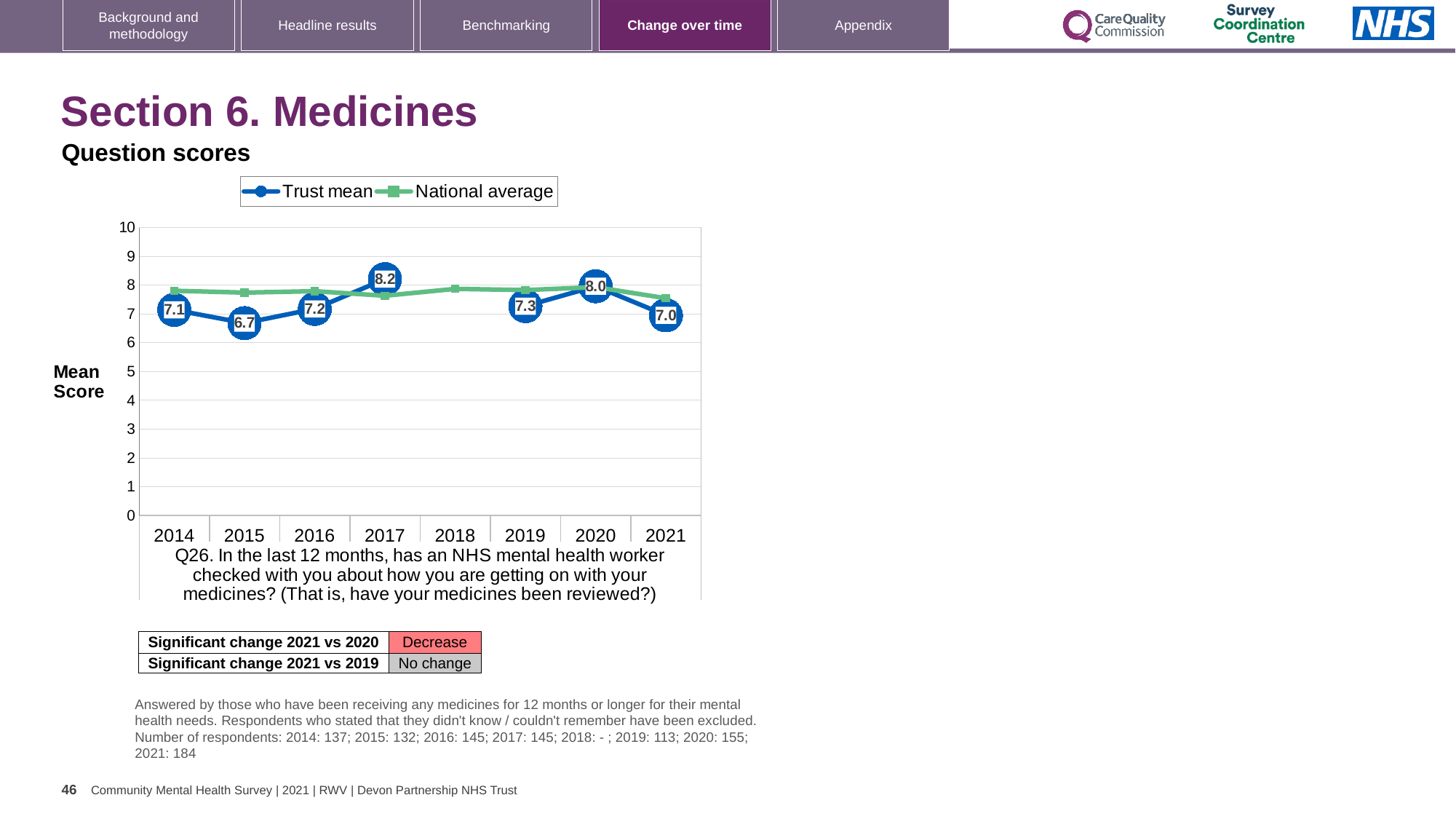
How many series does the legend list? 2 In which year is the Trust mean score lowest? 2015 What kind of chart is shown? Line chart What is the Trust mean score for 2015? 6.7 What is the Trust mean score for 2021? 7.0 Which is larger, the Trust mean score for 2016 or for 2019? 2019 What is the difference between the Trust mean scores for 2020 and 2021? 1.0 How many years are shown on the x axis? 8 In which year is the Trust mean score highest? 2017 Does the Trust mean score rise or fall from 2020 to 2021? Fall What is the Trust mean score for 2017? 8.2 Is the National average value for 2018 greater or less than 7? greater